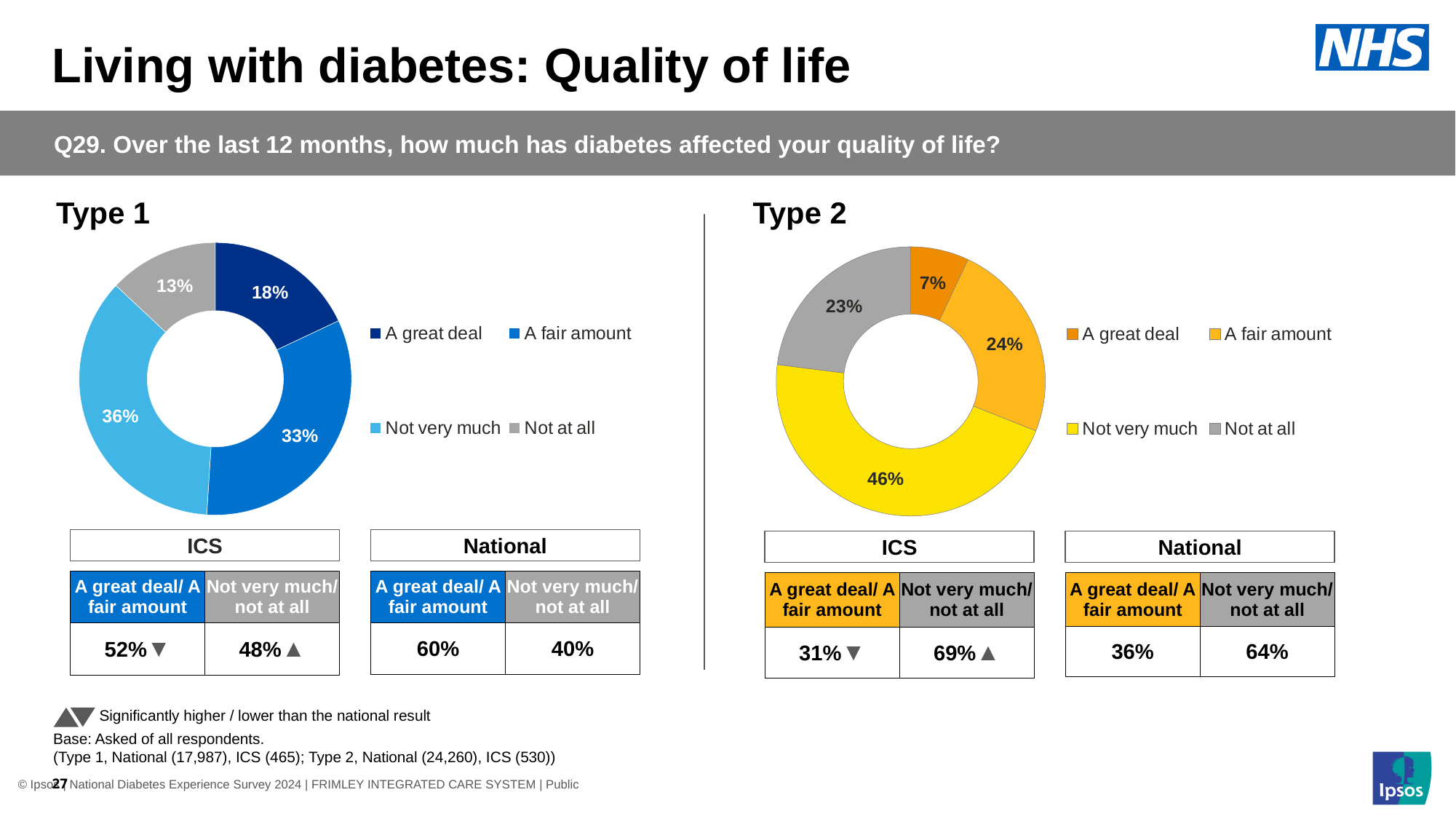
What kind of chart is used for Type 2? Doughnut chart In the Type 2 chart, what is the combined share of 'A great deal' and 'A fair amount'? 31% In the Type 1 chart, what is the difference between the 'A fair amount' and 'A great deal' shares? 15% In the Type 1 chart, what percentage of respondents said 'Not at all'? 13% In the Type 2 chart, which category has the smallest share? A great deal In the Type 1 chart, what is the difference between the 'Not very much' and 'Not at all' shares? 23% In the Type 2 chart, what colour is the 'Not very much' segment? Yellow In the Type 2 chart, what percentage of respondents said 'Not very much'? 46% How many categories does the Type 1 chart show? 4 In the Type 1 chart, which category has the largest share? Not very much In the Type 1 chart, what percentage of respondents said 'A great deal'? 18% In the Type 2 chart, which is larger: 'A fair amount' or 'Not at all'? A fair amount